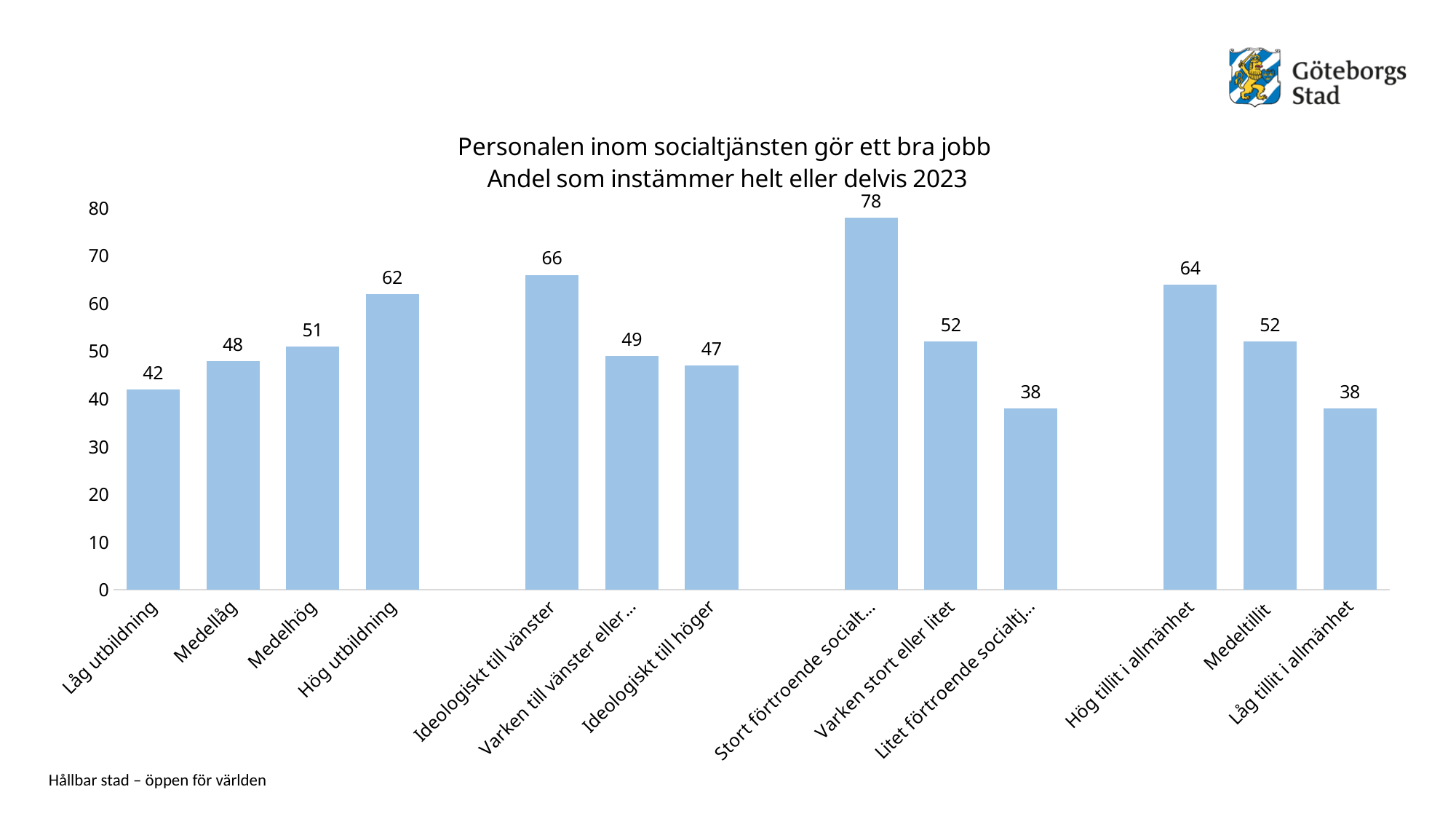
How many bars are shown in the chart? 13 What is the highest value shown in the chart? 78 What is the first line of the chart title? Personalen inom socialtjänsten gör ett bra jobb What is the value for Hög tillit i allmänhet? 64 What is the value for Hög utbildning? 62 What is the value for Medeltillit? 52 What is the lowest value shown in the chart? 38 What is the value for Ideologiskt till vänster? 66 What type of chart is shown on the slide? bar chart Which is larger, the value for Ideologiskt till vänster or the value for Ideologiskt till höger? Ideologiskt till vänster What is the difference between the values for Hög utbildning and Låg utbildning? 20 What is the value for Låg utbildning? 42